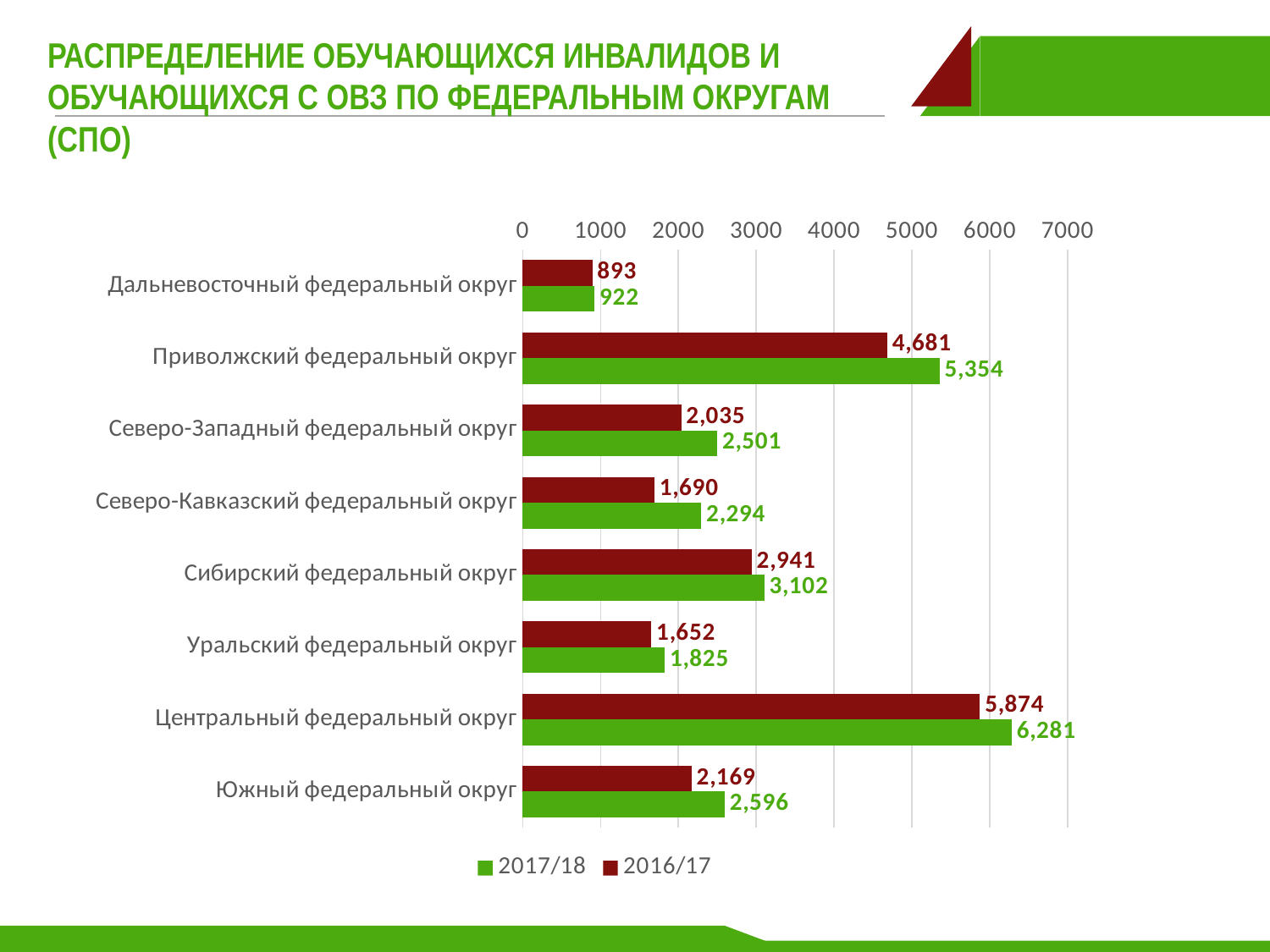
Which federal district has the lowest value in the 2016/17 series? Дальневосточный федеральный округ How many series does the legend list? 2 Is the 2016/17 value for Северо-Западный федеральный округ greater or less than 3000? less What is the value for Уральский федеральный округ in the 2016/17 series? 1,652 What is the value for Приволжский федеральный округ in the 2017/18 series? 5,354 What kind of chart is shown on the slide? bar chart Which is larger for Сибирский федеральный округ: the 2016/17 value or the 2017/18 value? 2017/18 How many federal districts are shown on the chart? 8 Which federal district has the highest value in the 2017/18 series? Центральный федеральный округ What is the difference between the 2017/18 and 2016/17 values for Центральный федеральный округ? 407 What is the difference between the 2017/18 and 2016/17 values for Северо-Кавказский федеральный округ? 604 What is the value for Южный федеральный округ in the 2017/18 series? 2,596